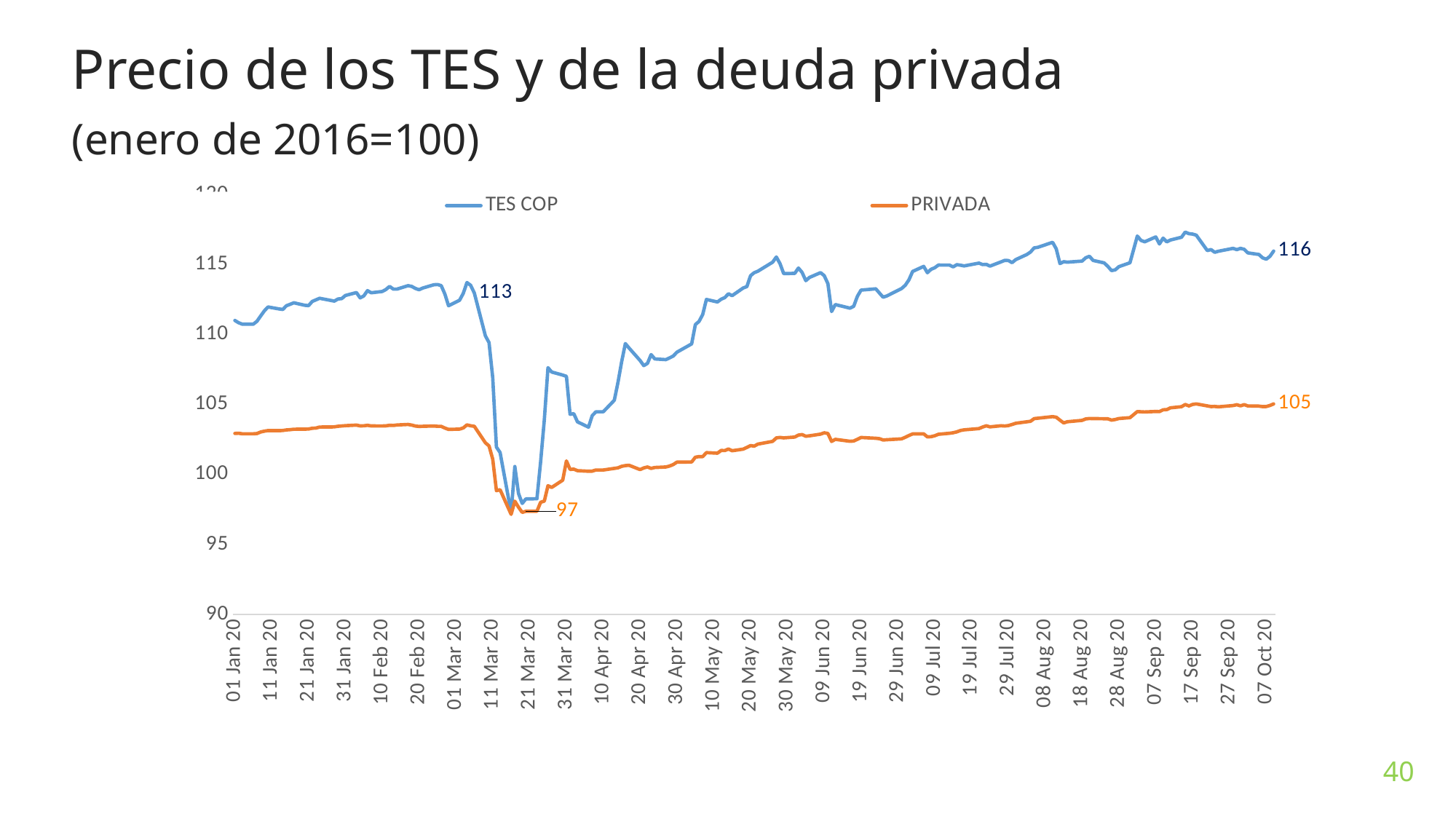
What is the last labelled value of the PRIVADA series, at 07 Oct 20? 105 Is the lowest value of TES COP in March 2020 greater or less than 100? less Does the PRIVADA series rise or fall from 31 Mar 20 to 07 Oct 20? rise What is the labelled low value of the PRIVADA series in March 2020? 97 Is the value of PRIVADA on 01 Jan 20 greater or less than 100? greater What is the last labelled value of the TES COP series, at 07 Oct 20? 116 At 07 Oct 20, which series has the higher value, TES COP or PRIVADA? TES COP What is the difference between the final labelled values of TES COP (116) and PRIVADA (105)? 11 What value is labelled on the TES COP series around 01 Mar 20, just before the drop? 113 What colour is the PRIVADA line in the legend? orange What kind of chart is shown on the slide? line chart How many series does the legend list? 2